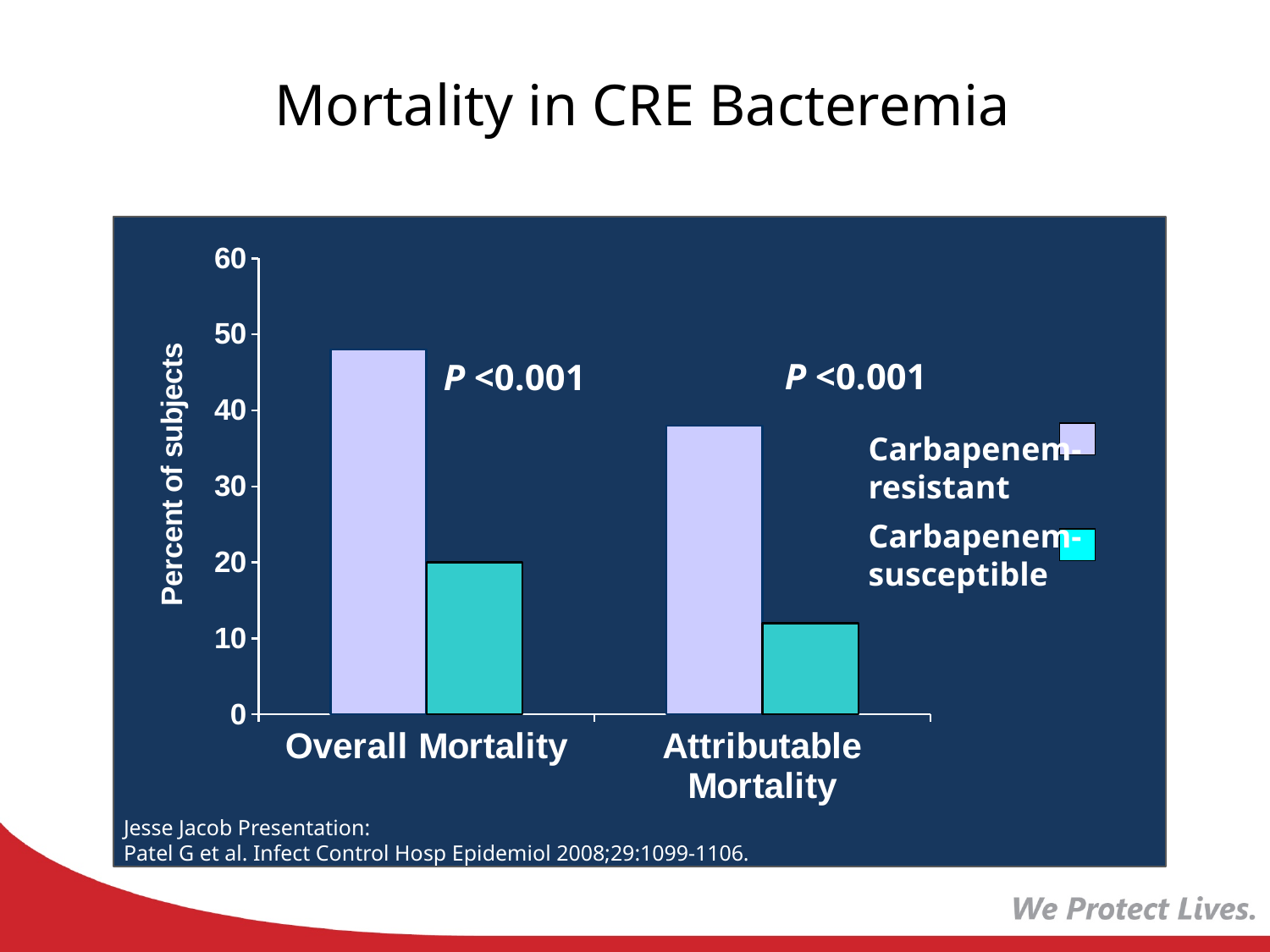
How many categories are shown on the x axis? 2 Is the value for Carbapenem-susceptible Attributable Mortality greater or less than 20? less Is the value for Carbapenem-resistant Attributable Mortality greater or less than 40? less Which series has the higher value for Attributable Mortality? Carbapenem-resistant How many series does the legend list? 2 Which bar is the shortest in the chart? Carbapenem-susceptible, Attributable Mortality Which bar is the tallest in the chart? Carbapenem-resistant, Overall Mortality Is the value for Carbapenem-resistant Overall Mortality greater or less than 40? greater What kind of chart is shown on the slide? bar chart Which series has the higher value for Overall Mortality? Carbapenem-resistant What is the title of the chart? Mortality in CRE Bacteremia What is the label of the y axis? Percent of subjects